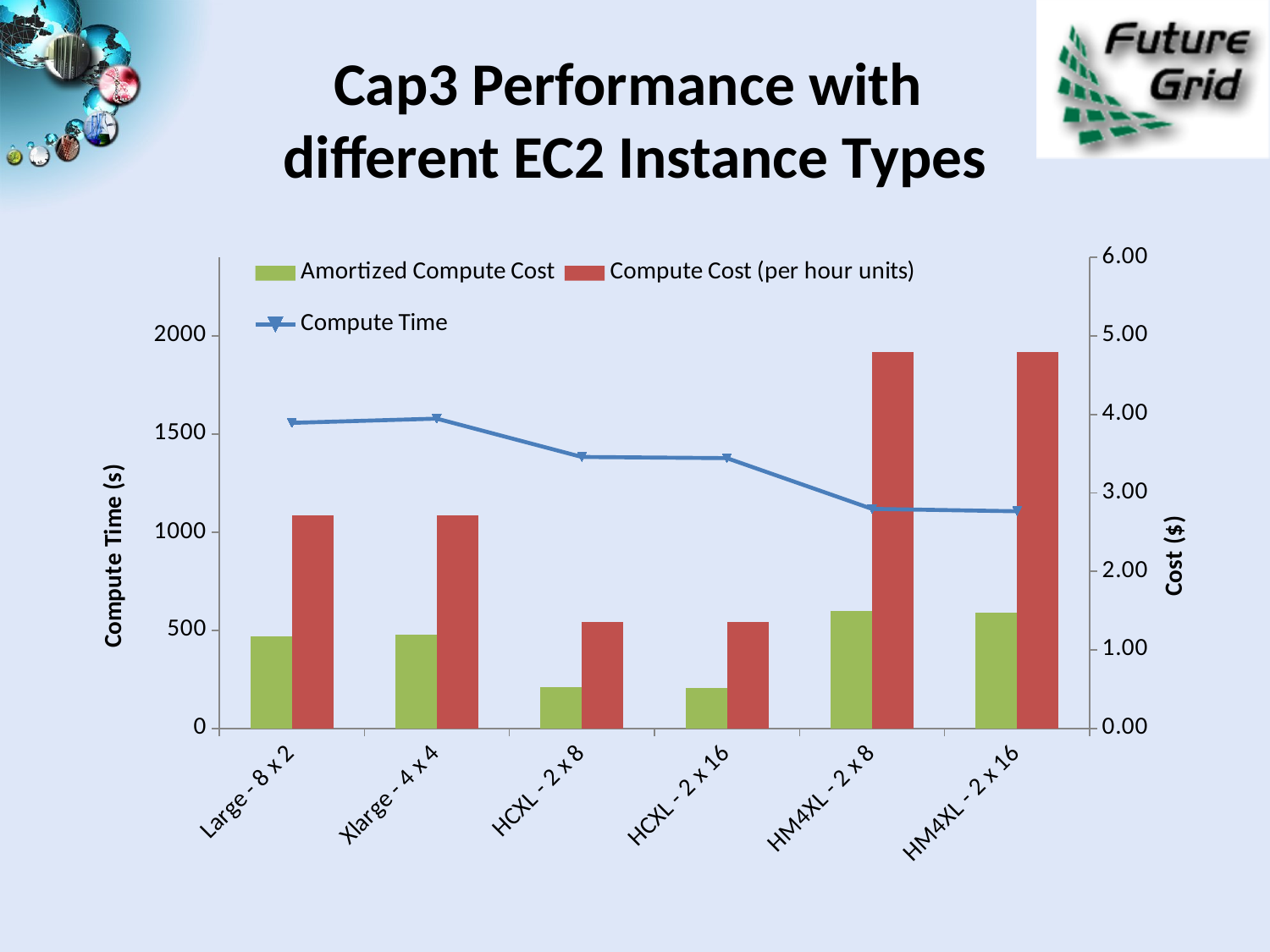
What kind of chart is shown on the slide? Combined bar and line chart Is the Compute Time for HM4XL - 2 x 8 greater or less than 1500? less Which has the larger Compute Cost (per hour units): Large - 8 x 2 or HCXL - 2 x 8? Large - 8 x 2 How many series does the chart legend list? 3 Is the Compute Cost (per hour units) for HM4XL - 2 x 8 greater or less than 4.00? greater What is the title of the chart on the slide? Cap3 Performance with different EC2 Instance Types Is the Amortized Compute Cost for HCXL - 2 x 8 greater or less than 1.00? less Does the Compute Time line rise or fall from left to right across the instance types? Fall How many EC2 instance type categories are shown on the x axis? 6 Which has the larger Compute Time: Large - 8 x 2 or HM4XL - 2 x 16? Large - 8 x 2